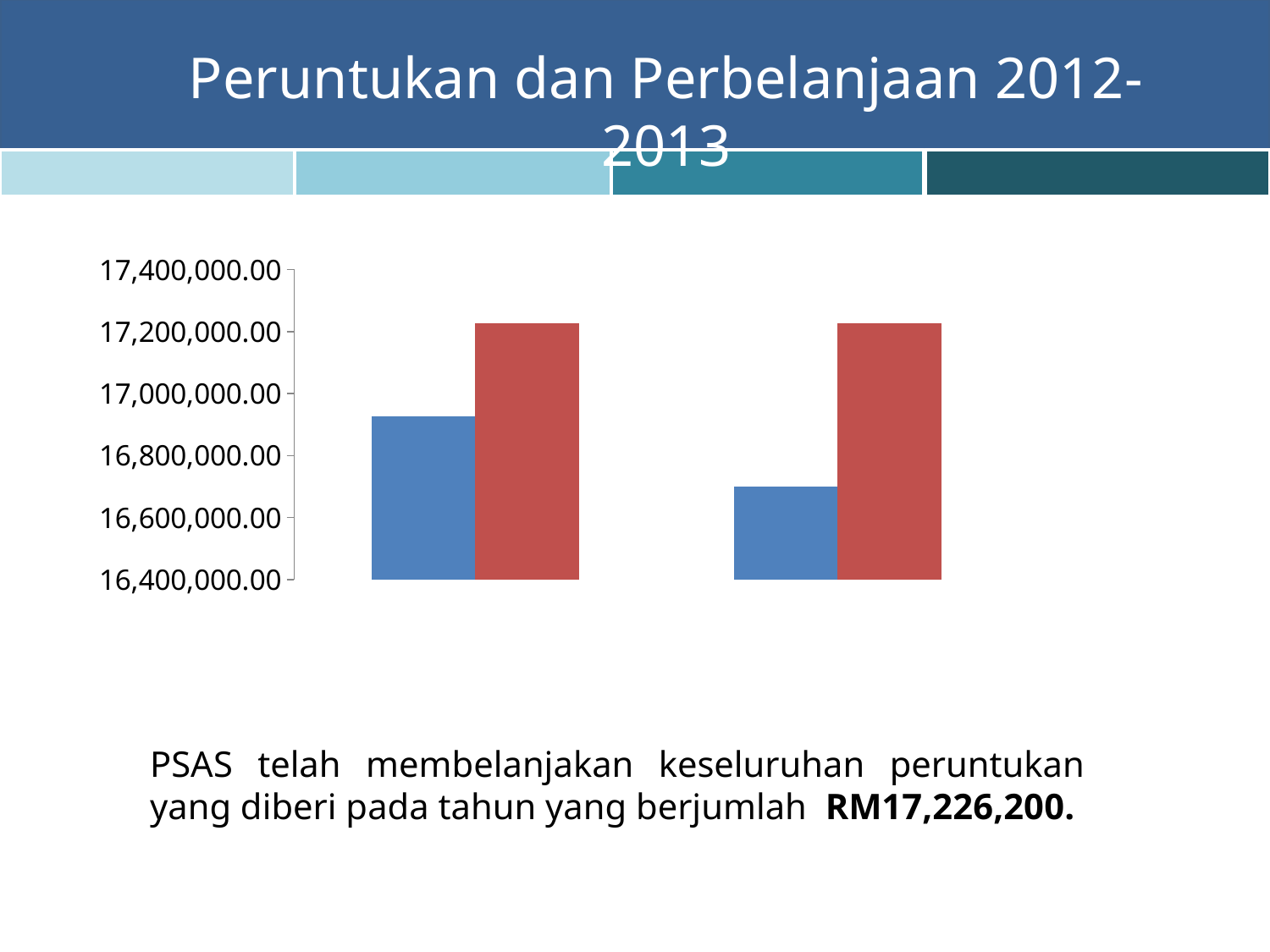
Is the value of the red bar in the right group greater or less than 17,000,000.00? greater How many differently coloured bars (series) appear in each group of the chart? 2 In the left group of bars, which bar is taller, the blue bar or the red bar? the red bar Is the value of the blue bar in the left group greater or less than 16,800,000.00? greater What is the highest value shown on the vertical axis of the chart? 17,400,000.00 What kind of chart is shown on the slide? bar chart How many groups of bars are plotted in the chart? 2 Is the value of the blue bar in the right group greater or less than 16,800,000.00? less In the right group of bars, which bar is taller, the blue bar or the red bar? the red bar What is the title of the slide containing the chart? Peruntukan dan Perbelanjaan 2012-2013 Which blue bar is taller, the one in the left group or the one in the right group? the one in the left group